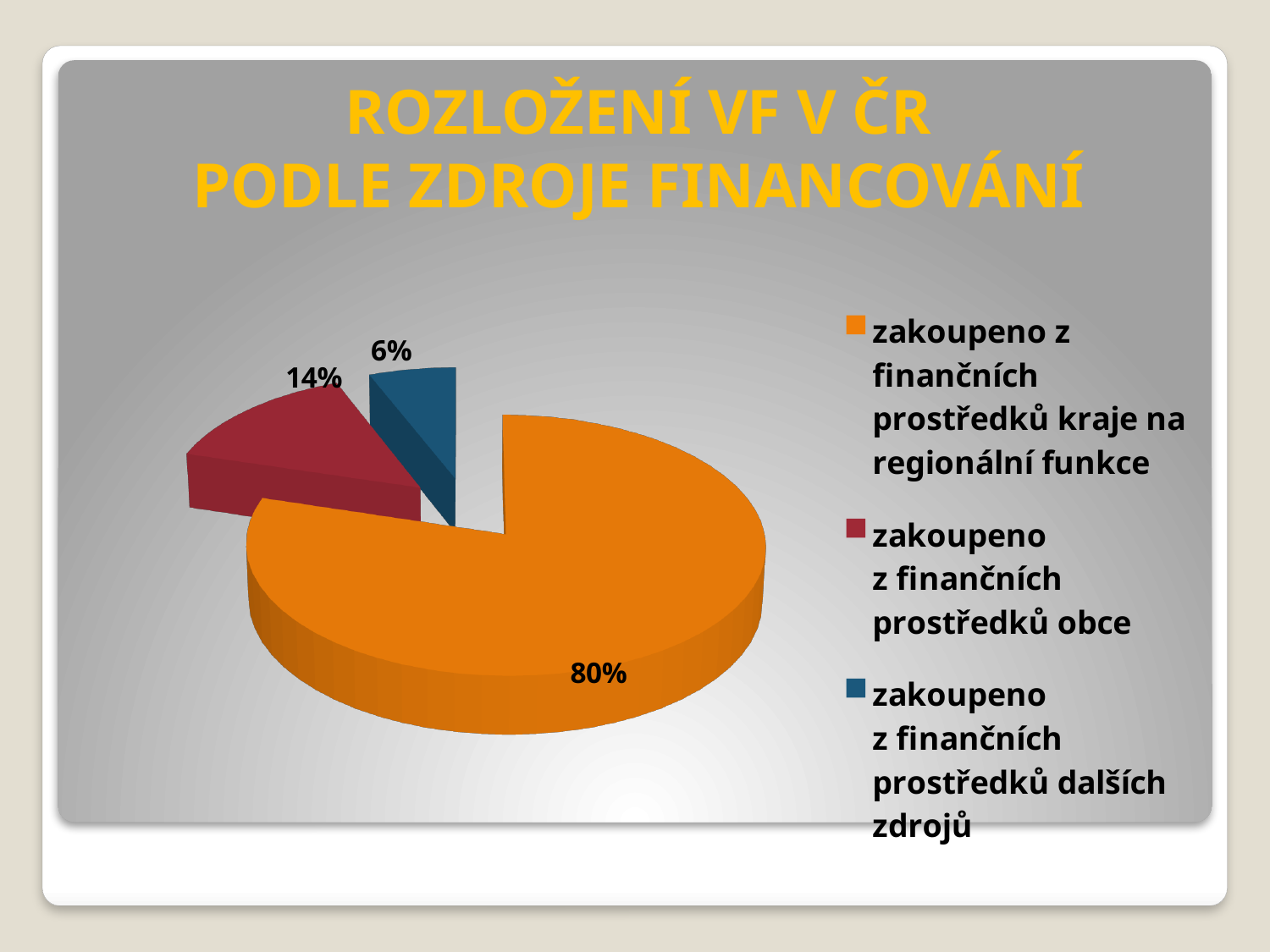
How many entries does the legend list? 3 Which category has the largest slice of the pie? zakoupeno z finančních prostředků kraje na regionální funkce What share of the pie is 'zakoupeno z finančních prostředků obce'? 14% What is the difference in percentage points between the 'kraje na regionální funkce' slice and the 'obce' slice? 66 What is the difference in percentage points between the 'obce' slice and the 'dalších zdrojů' slice? 8 Which category has the smallest slice of the pie? zakoupeno z finančních prostředků dalších zdrojů How many slices does the pie chart have? 3 What colour is the slice for 'zakoupeno z finančních prostředků obce'? red What share of the pie is 'zakoupeno z finančních prostředků kraje na regionální funkce'? 80% What share of the pie is 'zakoupeno z finančních prostředků dalších zdrojů'? 6% What kind of chart is shown on the slide? pie chart Which is larger: the slice for 'zakoupeno z finančních prostředků obce' or the slice for 'zakoupeno z finančních prostředků dalších zdrojů'? zakoupeno z finančních prostředků obce